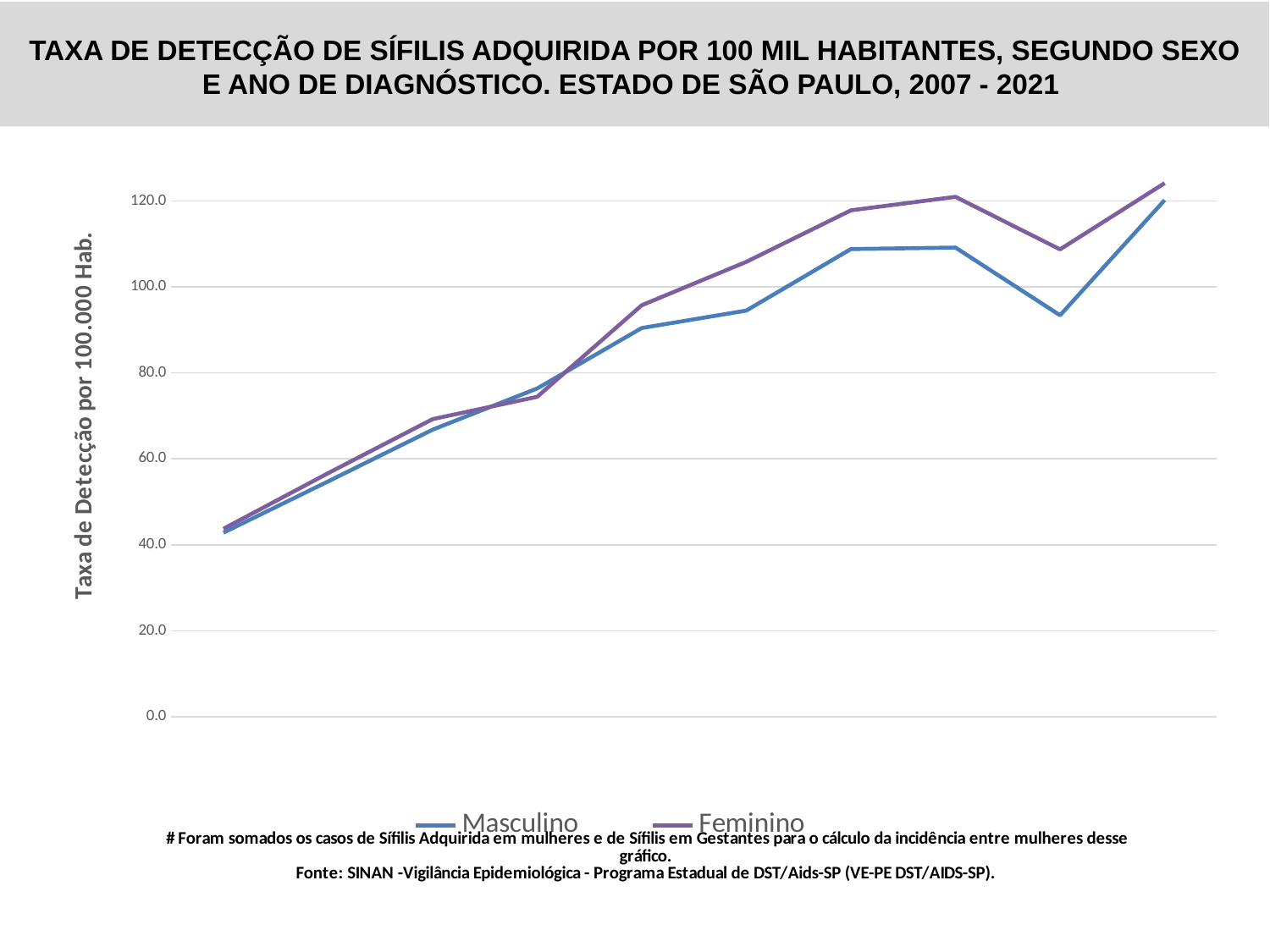
Do the values of the Feminino line generally rise or fall from left to right? Rise Is the value at the dip of the Masculino line near the right side greater or less than 100.0? less What is the title of the vertical axis? Taxa de Detecção por 100.000 Hab. At the last point on the right, which series has the larger value, Masculino or Feminino? Feminino How many series does the legend list? 2 What are the two series named in the legend? Masculino and Feminino Do the values of the Masculino line generally rise or fall from left to right? Rise What kind of chart is shown on the slide? Line chart Which series reaches the highest value on the chart? Feminino Is the first value of the Masculino line greater or less than 60.0? less Is the last value of the Feminino line greater or less than 120.0? greater